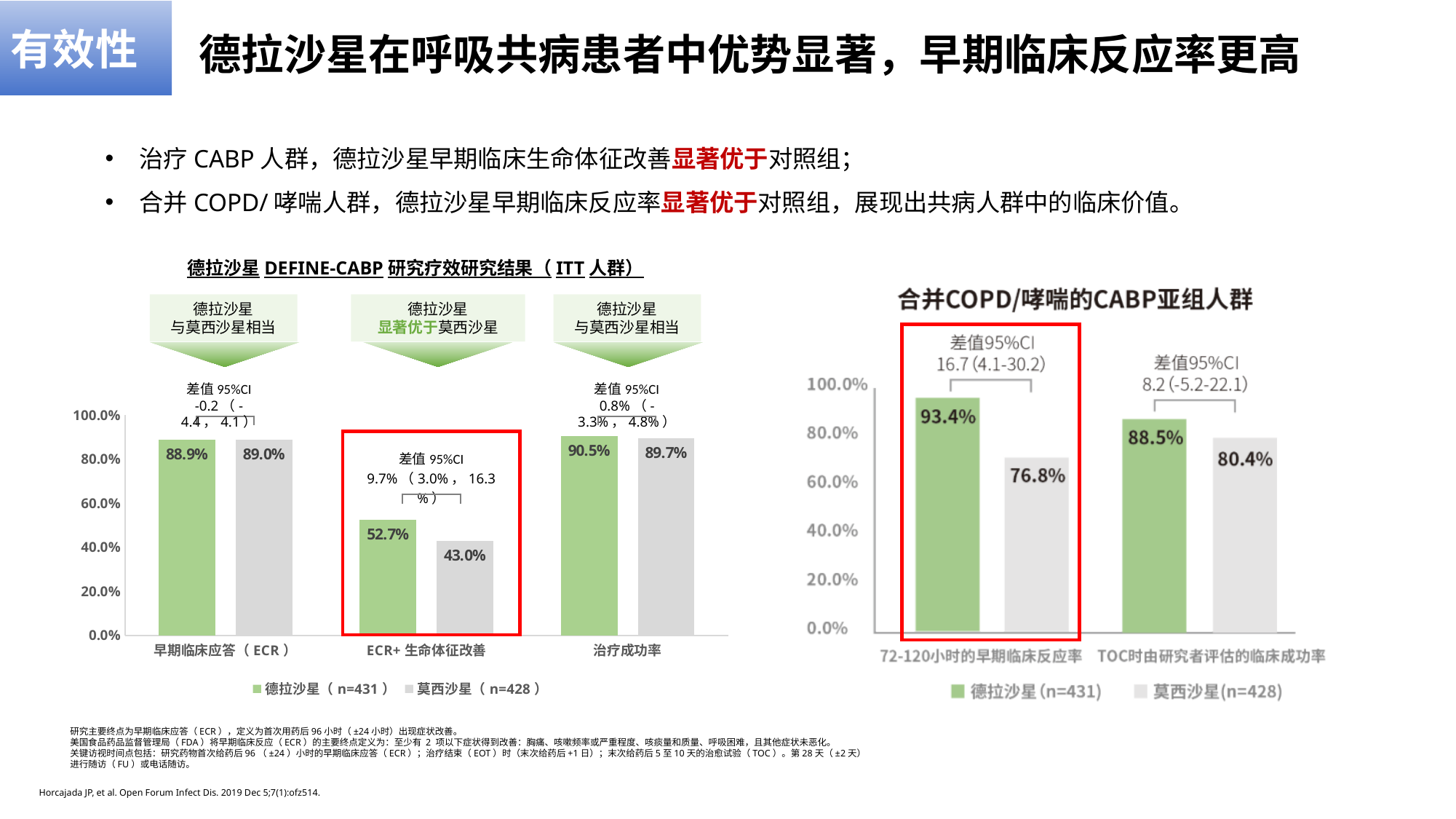
In the right chart (合并COPD/哮喘的CABP亚组人群), which is larger in the 72-120小时的早期临床反应率 category, 德拉沙星 or 莫西沙星? 德拉沙星 In the left chart (德拉沙星 DEFINE-CABP 研究疗效研究结果), how many categories are shown on the x axis? 3 What kind of chart is the right chart (合并COPD/哮喘的CABP亚组人群)? Bar chart In the right chart (合并COPD/哮喘的CABP亚组人群), what is the value for 德拉沙星 in the 72-120小时的早期临床反应率 category? 93.4% In the left chart (德拉沙星 DEFINE-CABP 研究疗效研究结果), what is the value for 莫西沙星 in the 早期临床应答（ECR） category? 89.0% In the left chart (德拉沙星 DEFINE-CABP 研究疗效研究结果), what is the value for 德拉沙星 in the ECR+ 生命体征改善 category? 52.7% In the right chart (合并COPD/哮喘的CABP亚组人群), what is the value for 莫西沙星 in the TOC时由研究者评估的临床成功率 category? 80.4% In the left chart (德拉沙星 DEFINE-CABP 研究疗效研究结果), which category has the lowest value for 莫西沙星? ECR+ 生命体征改善 In the left chart (德拉沙星 DEFINE-CABP 研究疗效研究结果), how many series does the legend list? 2 In the left chart (德拉沙星 DEFINE-CABP 研究疗效研究结果), what is the difference between 德拉沙星 and 莫西沙星 in the ECR+ 生命体征改善 category? 9.7% In the right chart (合并COPD/哮喘的CABP亚组人群), what is the difference between 德拉沙星 and 莫西沙星 in the TOC时由研究者评估的临床成功率 category? 8.1% In the right chart (合并COPD/哮喘的CABP亚组人群), what sample size does the legend give for 莫西沙星? n=428